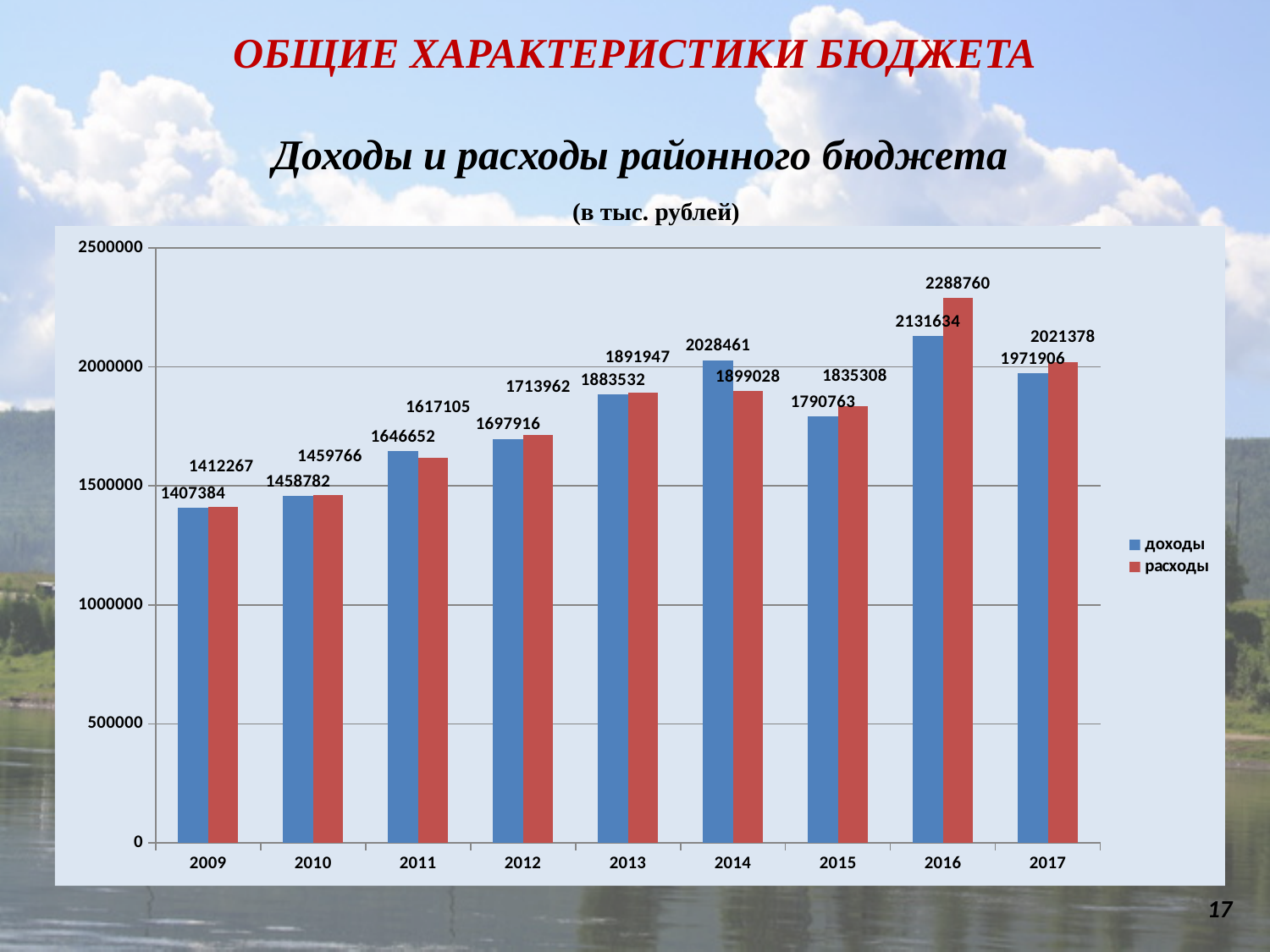
In 2014, which is larger: доходы or расходы? доходы How many series does the legend list? 2 In which year are доходы the lowest? 2009 What is the value of расходы for 2016? 2288760 In which year are расходы the highest? 2016 What type of chart is shown on the slide? Bar chart What is the difference between расходы and доходы in 2016? 157126 What is the value of доходы for 2014? 2028461 Is the value of расходы for 2015 greater or less than 2000000? less Which colour represents расходы in the chart? Red What is the value of доходы for 2009? 1407384 How many years are shown on the x axis? 9